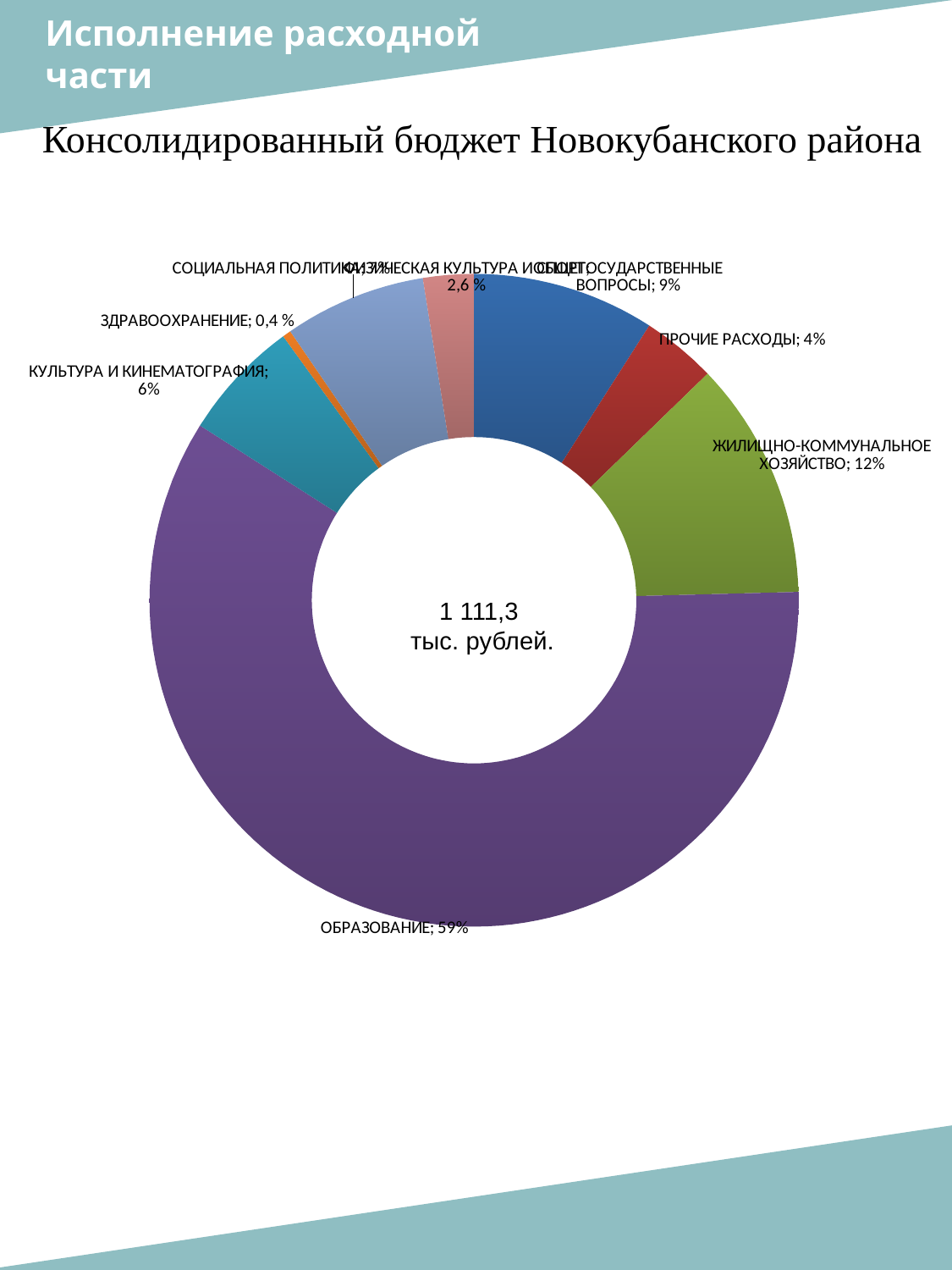
What is the value shown for ЖИЛИЩНО-КОММУНАЛЬНОЕ ХОЗЯЙСТВО? 12% Which category has the smallest share of the chart? ЗДРАВООХРАНЕНИЕ What is the value shown for ОБЩЕГОСУДАРСТВЕННЫЕ ВОПРОСЫ? 9% Which is larger: ОБЩЕГОСУДАРСТВЕННЫЕ ВОПРОСЫ or ПРОЧИЕ РАСХОДЫ? ОБЩЕГОСУДАРСТВЕННЫЕ ВОПРОСЫ What is the value shown for ПРОЧИЕ РАСХОДЫ? 4% What is the value shown for ФИЗИЧЕСКАЯ КУЛЬТУРА И СПОРТ? 2,6 % What is the value shown for ЗДРАВООХРАНЕНИЕ? 0,4 % Which category has the largest share of the chart? ОБРАЗОВАНИЕ What is the value shown for КУЛЬТУРА И КИНЕМАТОГРАФИЯ? 6% What share of the chart does ОБРАЗОВАНИЕ account for? 59% By how many percentage points does ОБРАЗОВАНИЕ exceed ЖИЛИЩНО-КОММУНАЛЬНОЕ ХОЗЯЙСТВО? 47% What total amount is written in the centre of the chart? 1 111,3 тыс. рублей.